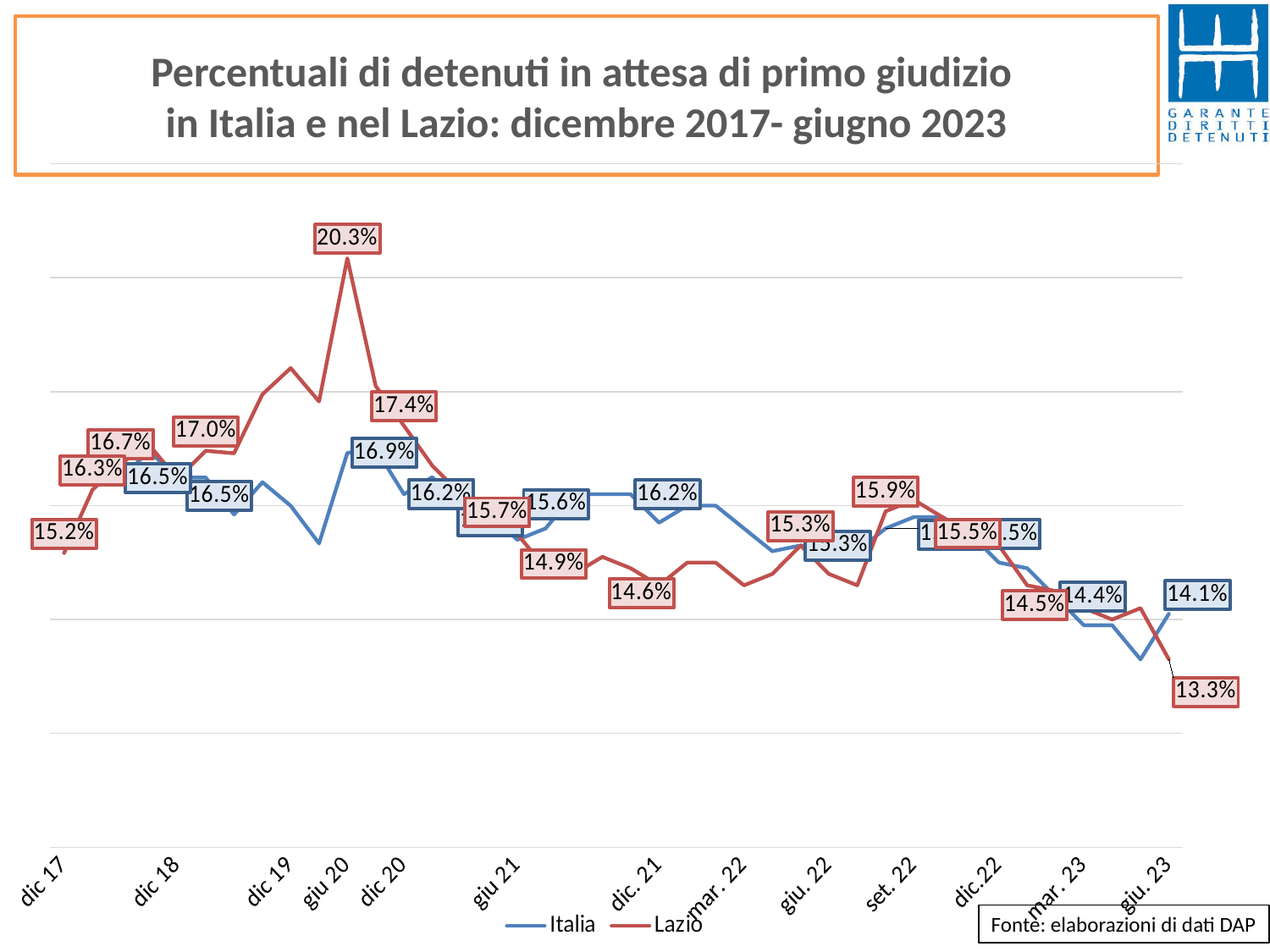
At giu 23, which series has the higher value, Italia or Lazio? Italia What is the value for Lazio at dic 17? 15.2% What is the difference between the Italia and Lazio values at giu 23? 0.8 percentage points Which two series are shown in the legend? Italia and Lazio What kind of chart is shown on the slide? Line chart Overall, do the values for Lazio rise or fall from dic 17 to giu 23? Fall What is the value for Lazio at giu 23? 13.3% What is the value for Italia at giu 23? 14.1% What is the highest value reached by the Lazio series? 20.3% How many series does the legend list? 2 What is the lowest labelled value of the Lazio series? 13.3% What is the title of the chart? Percentuali di detenuti in attesa di primo giudizio in Italia e nel Lazio: dicembre 2017- giugno 2023